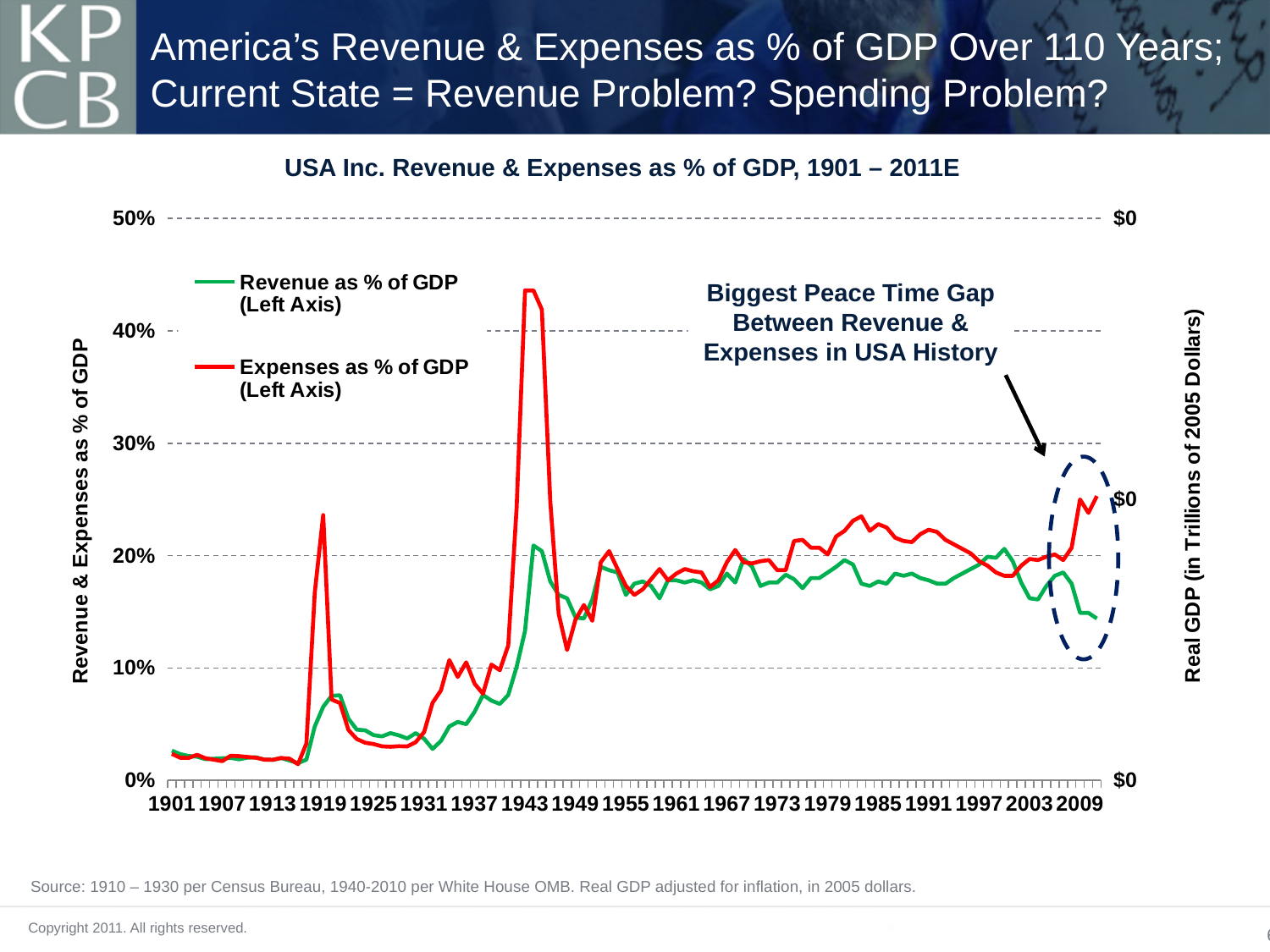
Is the peak value of Expenses as % of GDP around 1919 greater or less than 20%? greater What kind of chart is shown on the slide? line chart Is the value of Revenue as % of GDP in 1901 greater or less than 10%? less Around 1944, which series is larger: Revenue as % of GDP or Expenses as % of GDP? Expenses as % of GDP Is the peak value of Expenses as % of GDP around 1944 greater or less than 40%? greater What is the title of the chart? USA Inc. Revenue & Expenses as % of GDP, 1901 – 2011E Does Revenue as % of GDP rise or fall between 2007 and 2011? fall At the end of the series (around 2011), which is larger: Revenue as % of GDP or Expenses as % of GDP? Expenses as % of GDP Which colour is used for the Expenses as % of GDP line? red How many series does the legend list? 2